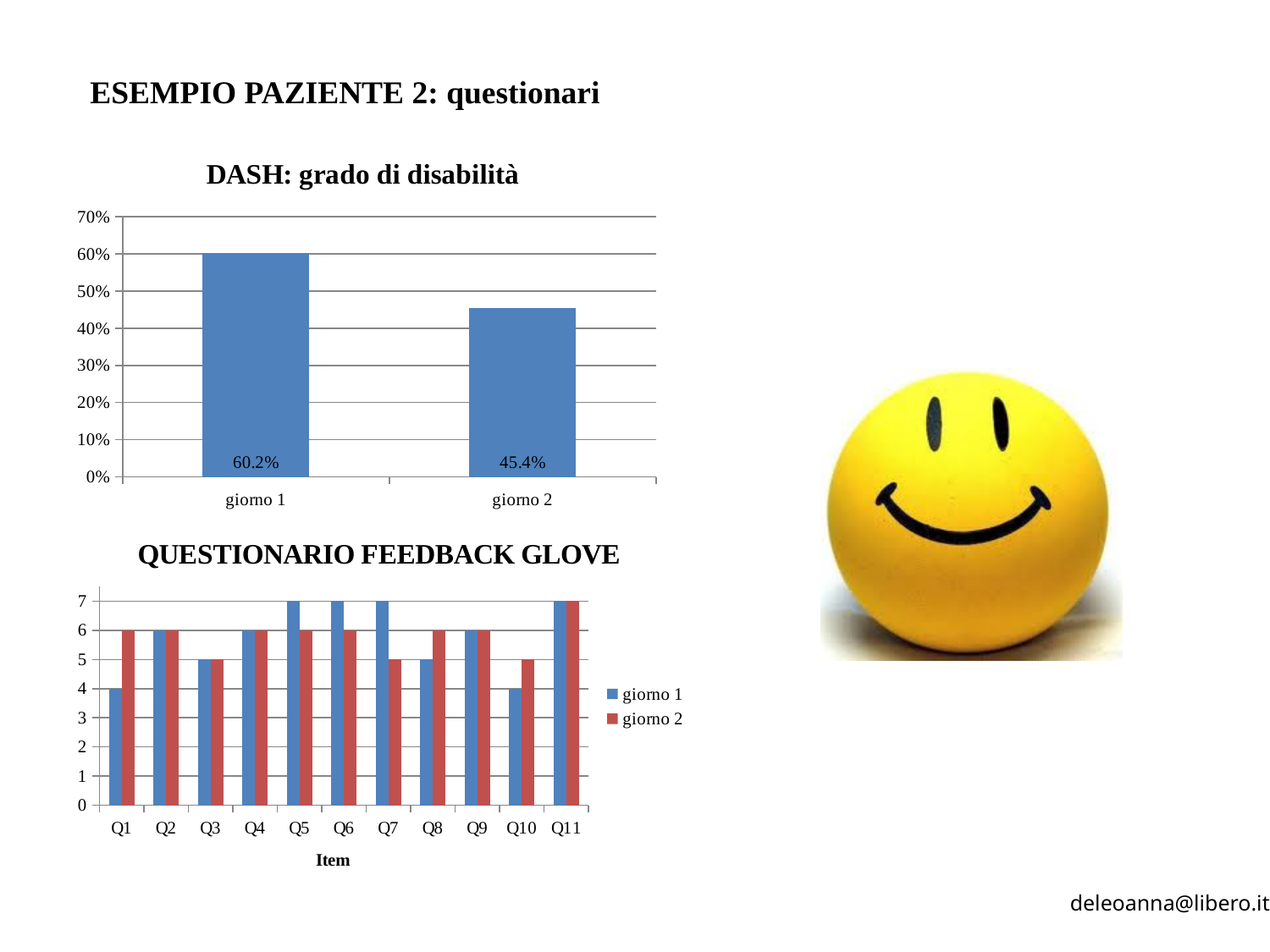
What kind of chart is 'DASH: grado di disabilità'? bar chart In the 'DASH: grado di disabilità' chart, do the values rise or fall from giorno 1 to giorno 2? fall In the 'QUESTIONARIO FEEDBACK GLOVE' chart, what is the label of the x axis? Item In the 'DASH: grado di disabilità' chart, what is the difference between giorno 1 and giorno 2? 14.8% In the 'QUESTIONARIO FEEDBACK GLOVE' chart, which is larger for Q10: giorno 1 or giorno 2? giorno 2 In the 'QUESTIONARIO FEEDBACK GLOVE' chart, what is the giorno 2 value for Q7? 5 In the 'DASH: grado di disabilità' chart, what is the value for giorno 1? 60.2% In the 'QUESTIONARIO FEEDBACK GLOVE' chart, how many items are shown on the x axis? 11 In the 'DASH: grado di disabilità' chart, which day has the higher value? giorno 1 In the 'QUESTIONARIO FEEDBACK GLOVE' chart, how many series does the legend list? 2 In the 'DASH: grado di disabilità' chart, what is the value for giorno 2? 45.4% In the 'QUESTIONARIO FEEDBACK GLOVE' chart, what is the giorno 1 value for Q1? 4